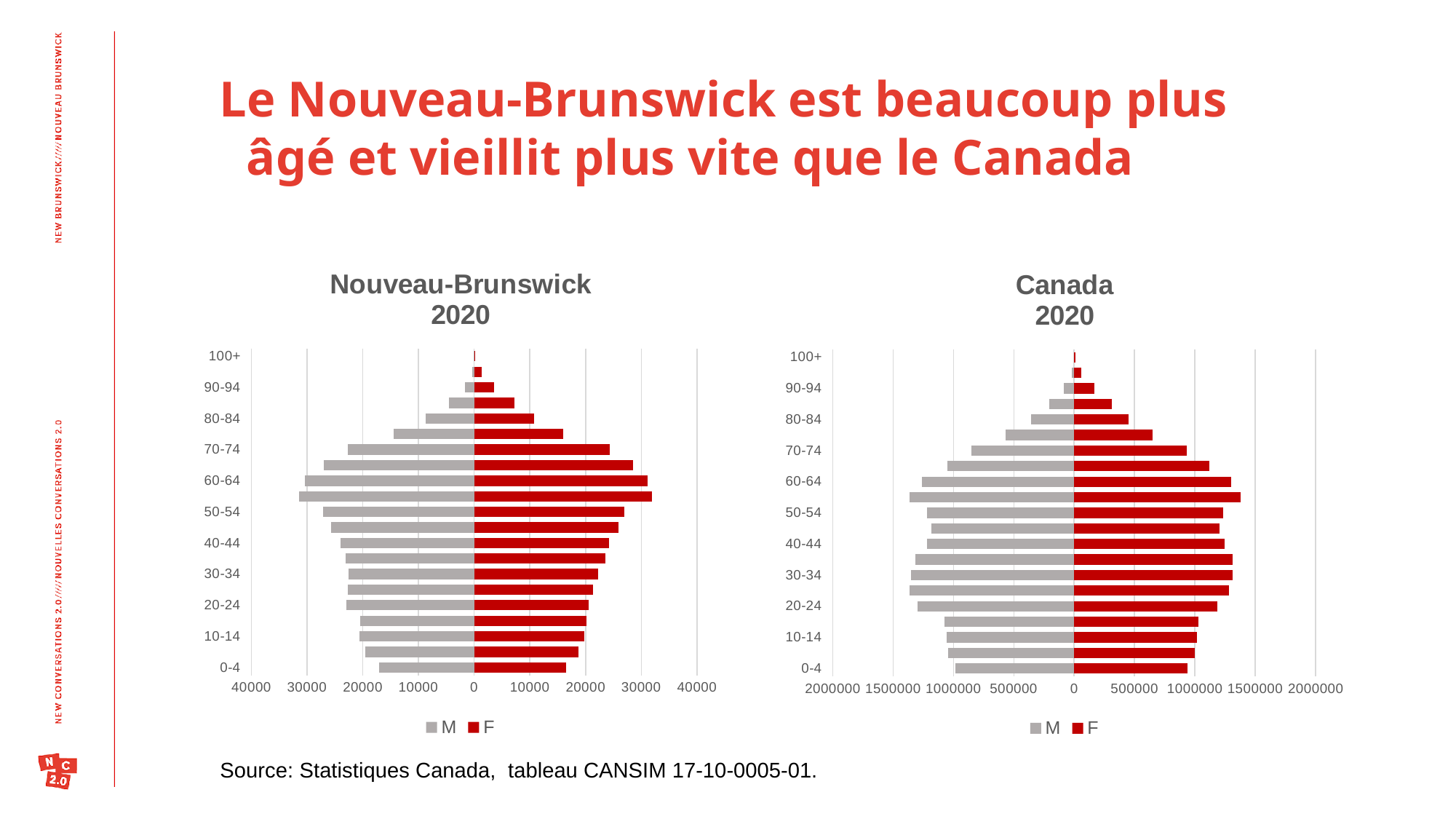
How many series does the legend of the Canada 2020 chart list? 2 In the Canada 2020 chart, which is larger: the M value for 30-34 or the M value for 80-84? 30-34 In the Nouveau-Brunswick 2020 chart, which colour represents the F series? red In the Nouveau-Brunswick 2020 chart, is the M value for the 70-74 age group greater or less than 20000? greater In the Nouveau-Brunswick 2020 chart, which is larger: the F value for 60-64 or the F value for 0-4? 60-64 In the Canada 2020 chart, which age group has the smallest F value? 100+ In the Canada 2020 chart, is the F value for the 60-64 age group greater or less than 1000000? greater What is the title of the chart on the right of the slide? Canada 2020 In the Canada 2020 chart, is the M value for the 80-84 age group greater or less than 500000? less What kind of chart is the Nouveau-Brunswick 2020 chart? bar chart